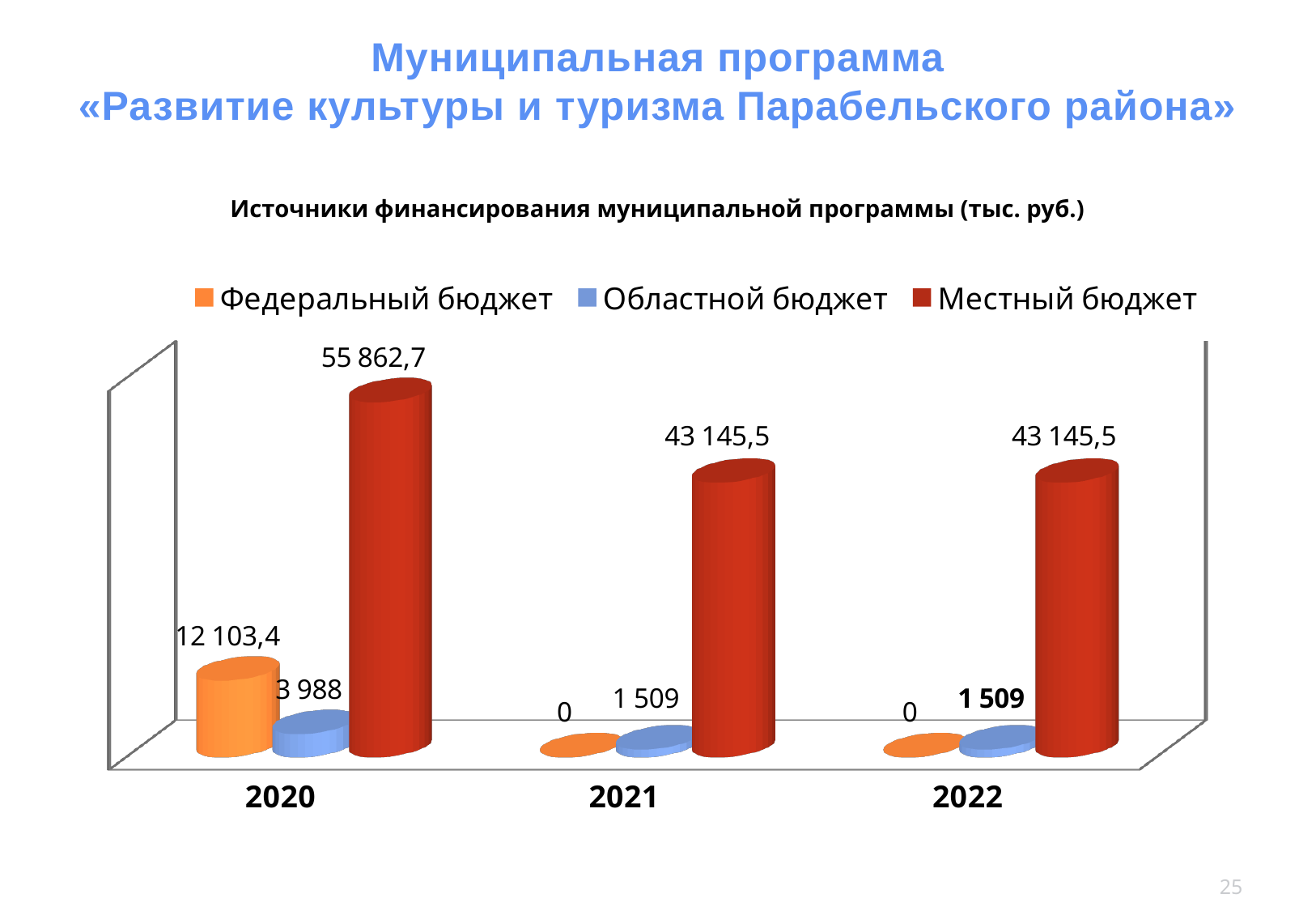
What is the value for Федеральный бюджет in 2020? 12 103,4 In which year is the Областной бюджет value lowest? 2021 and 2022 What is the total of all three budget sources in 2021? 44 654,5 Which is larger in 2020: Федеральный бюджет or Областной бюджет? Федеральный бюджет In which year is the Местный бюджет value highest? 2020 How many years are shown on the x axis? 3 What is the value for Областной бюджет in 2021? 1 509 What is the difference between the Местный бюджет values for 2020 and 2021? 12 717,2 What is the value for Местный бюджет in 2020? 55 862,7 What kind of chart is shown on the slide? Bar chart How many series does the legend list? 3 What is the value for Федеральный бюджет in 2022? 0